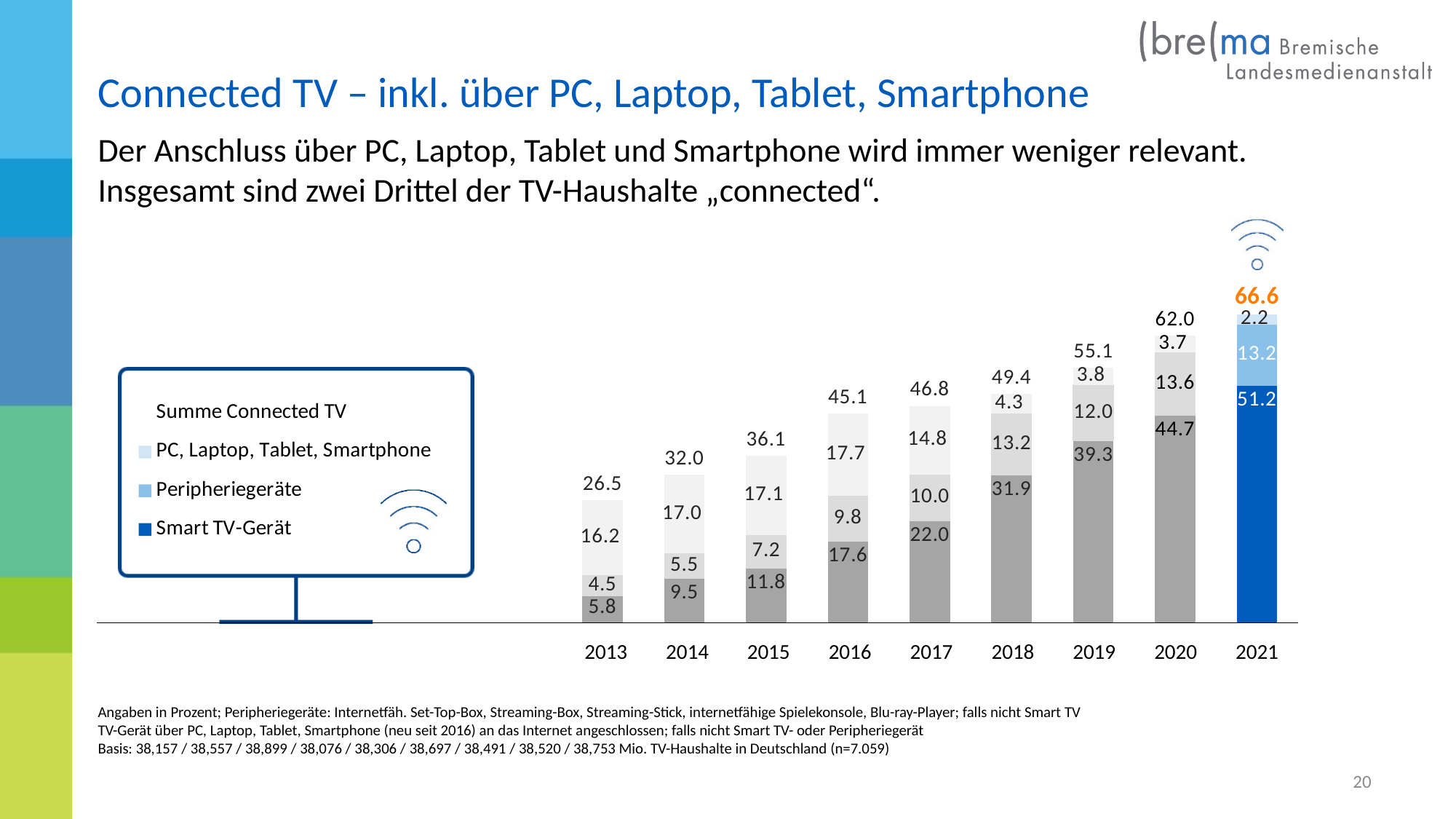
What is the value for Smart TV-Gerät in 2020? 44.7 Do the total Connected TV values rise or fall from 2013 to 2021? rise What is the total Connected TV value for 2021? 66.6 What is the value for PC, Laptop, Tablet, Smartphone in 2016? 17.7 What is the difference between the total Connected TV values for 2021 and 2020? 4.6 What type of chart is shown on the slide? stacked bar chart What is the value for Peripheriegeräte in 2017? 10.0 Which year has the lowest total Connected TV value? 2013 Which year has the highest total Connected TV value? 2021 Which is larger, the Smart TV-Gerät value in 2019 or in 2018? 2019 How many years are shown on the x axis of the chart? 9 How many series does the legend list? 4